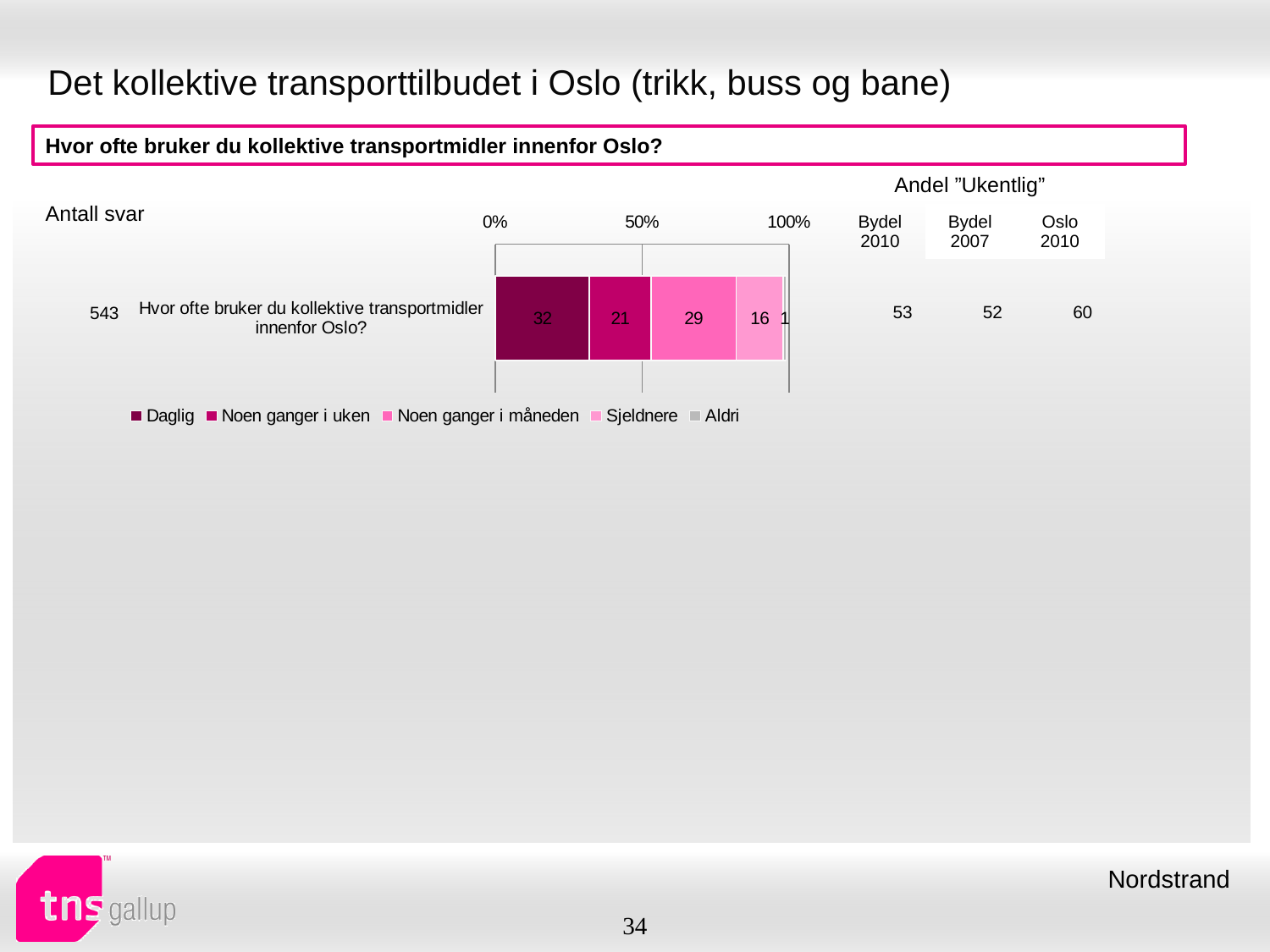
What is the value for "Noen ganger i måneden" in the stacked bar? 29 What is the "Antall svar" (number of responses) shown next to the bar? 543 What is the difference between the "Daglig" and "Noen ganger i uken" values? 11 What is the value for "Daglig" in the stacked bar? 32 What is the value for "Noen ganger i uken" in the stacked bar? 21 What is the value for "Sjeldnere" in the stacked bar? 16 What is the value for "Aldri" in the stacked bar? 1 What kind of chart is shown on the slide? Stacked bar chart Which series has the smallest segment in the stacked bar? Aldri Which series has the largest segment in the stacked bar? Daglig Which is larger, the "Noen ganger i måneden" value or the "Sjeldnere" value? Noen ganger i måneden How many series does the legend list? 5